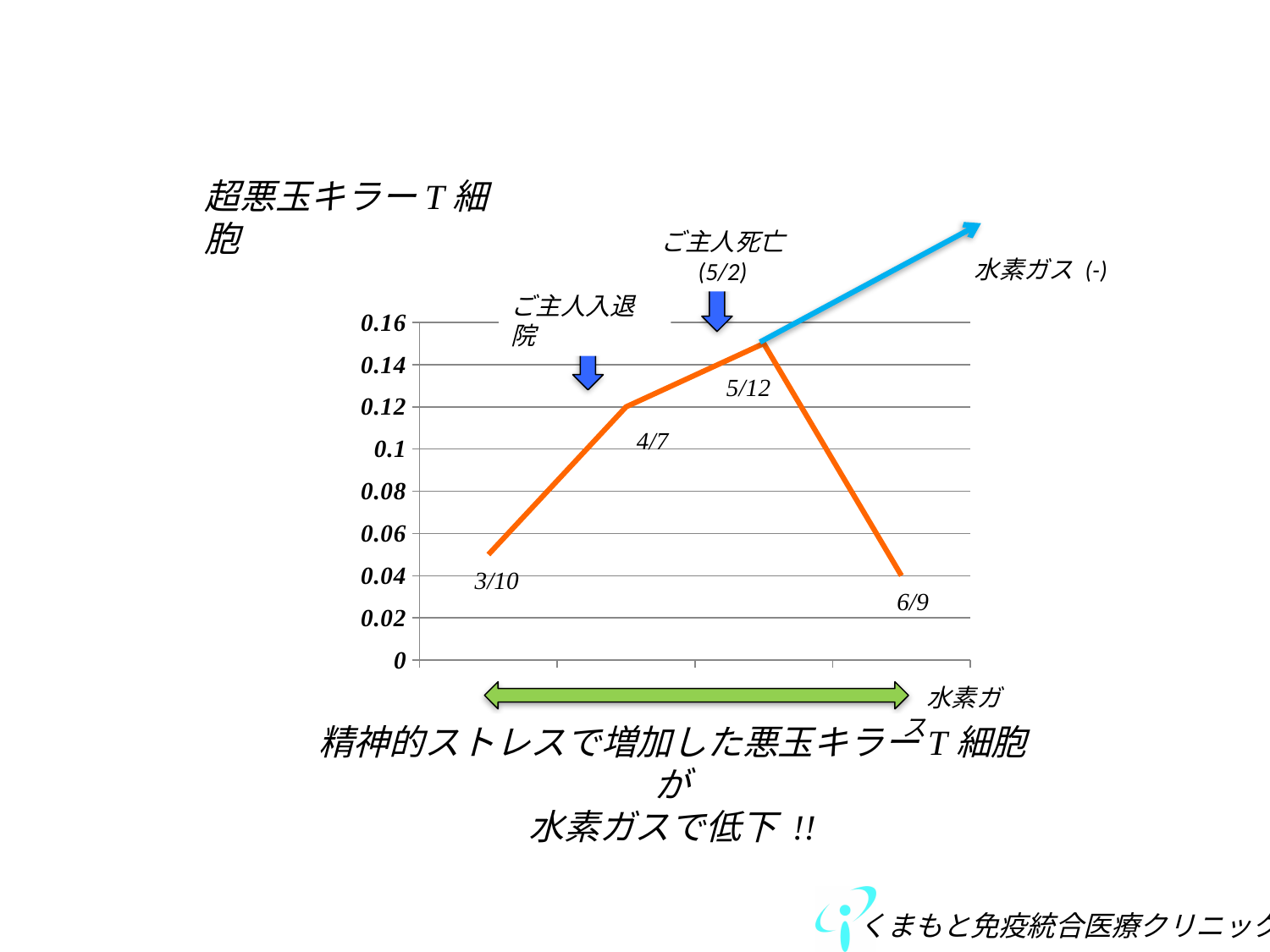
What kind of chart is shown on the slide? line chart Is the value for 3/10 greater or less than 0.06? less Is the value for 5/12 greater or less than 0.14? greater How does the line change from 3/10 to 6/9? rises until 5/12, then falls What is the value at 6/9? 0.04 Which date has the highest value on the line? 5/12 Which is larger, the value at 4/7 or the value at 6/9? 4/7 What is the value at 4/7? 0.12 What is the difference between the value at 4/7 and the value at 6/9? 0.08 What is the title of the chart? 超悪玉キラーT細胞 How many data points are plotted on the line? 4 Which date has the lowest value on the line? 6/9